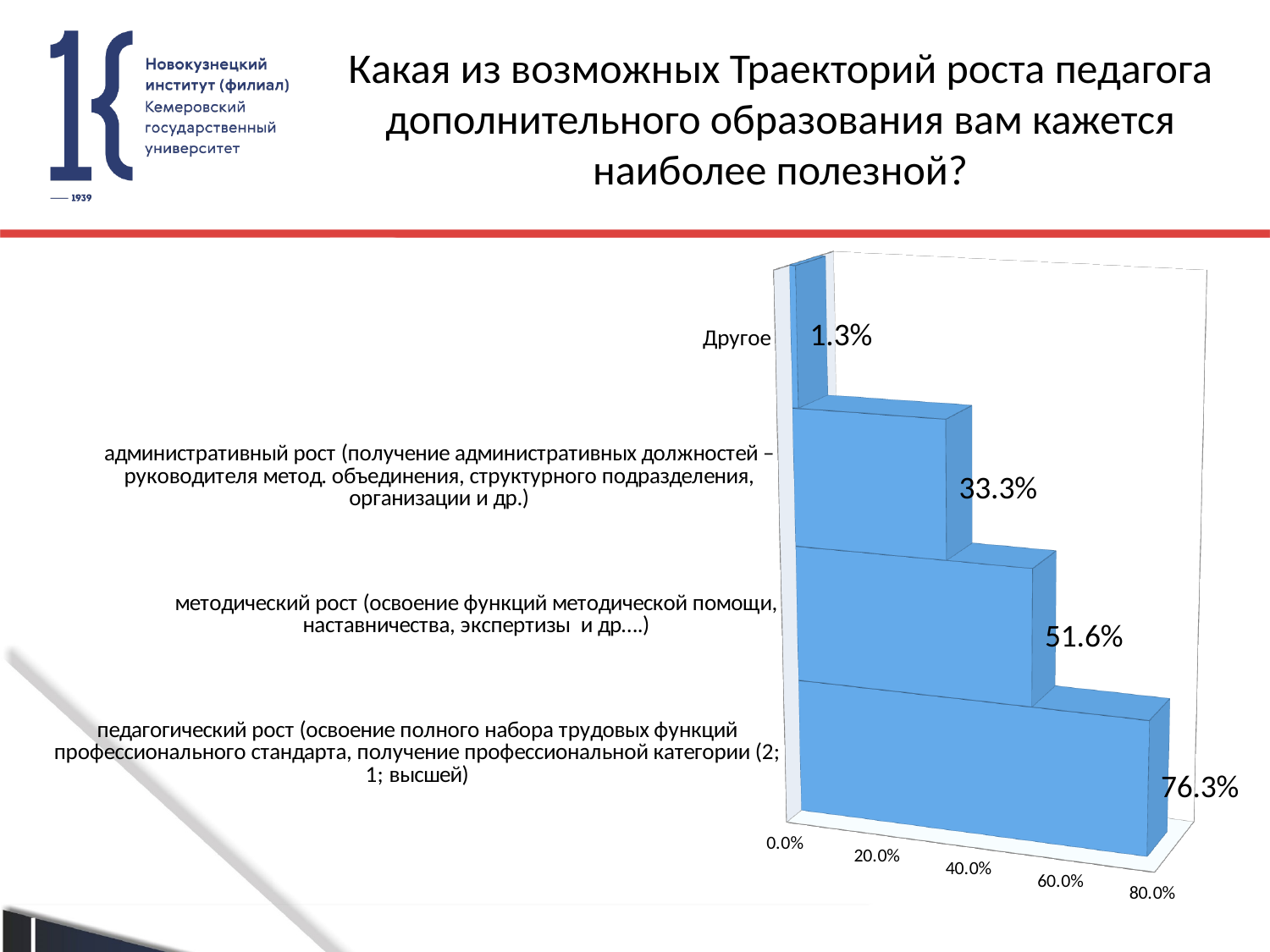
What kind of chart is shown on the slide? bar chart Which is larger: the value for "административный рост" or the value for "методический рост"? методический рост What percentage is shown for "педагогический рост"? 76.3% What is the difference between the values for "методический рост" and "административный рост"? 18.3% How many categories are shown in the chart? 4 Which category has the highest value? педагогический рост What percentage is shown for "Другое"? 1.3% What percentage is shown for "административный рост"? 33.3% What percentage is shown for "методический рост"? 51.6% Is the value for "педагогический рост" greater or less than 60.0%? greater Which category has the lowest value? Другое What is the difference between the values for "педагогический рост" and "методический рост"? 24.7%